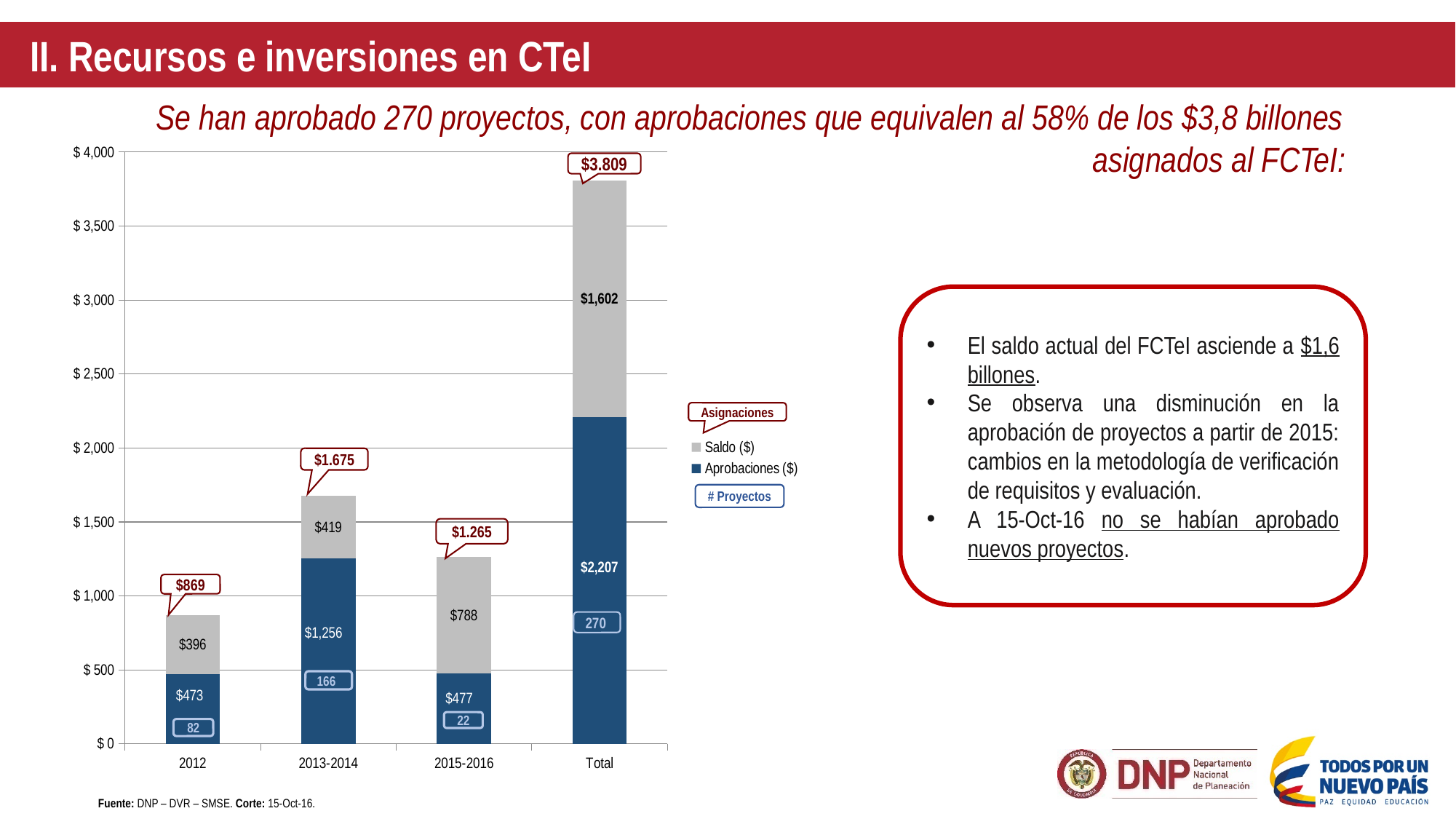
How many projects (# Proyectos) are shown for 2015-2016? 22 What is the total (Asignaciones) shown above the 2013-2014 bar? $1.675 What is the difference between the Saldo ($) values for 2015-2016 and 2013-2014? $369 What is the Aprobaciones ($) value for 2013-2014? $1,256 Which period has the lowest Saldo ($) value, excluding the Total bar? 2012 Which period has the highest Aprobaciones ($) value, excluding the Total bar? 2013-2014 What type of chart is shown on the slide? Stacked bar chart What is the total (Asignaciones) shown above the Total bar? $3.809 What is the Saldo ($) value for 2015-2016? $788 What is the Aprobaciones ($) value for 2012? $473 Is the Aprobaciones ($) value larger for 2012 or for 2015-2016? 2015-2016 How many series does the legend list? 2